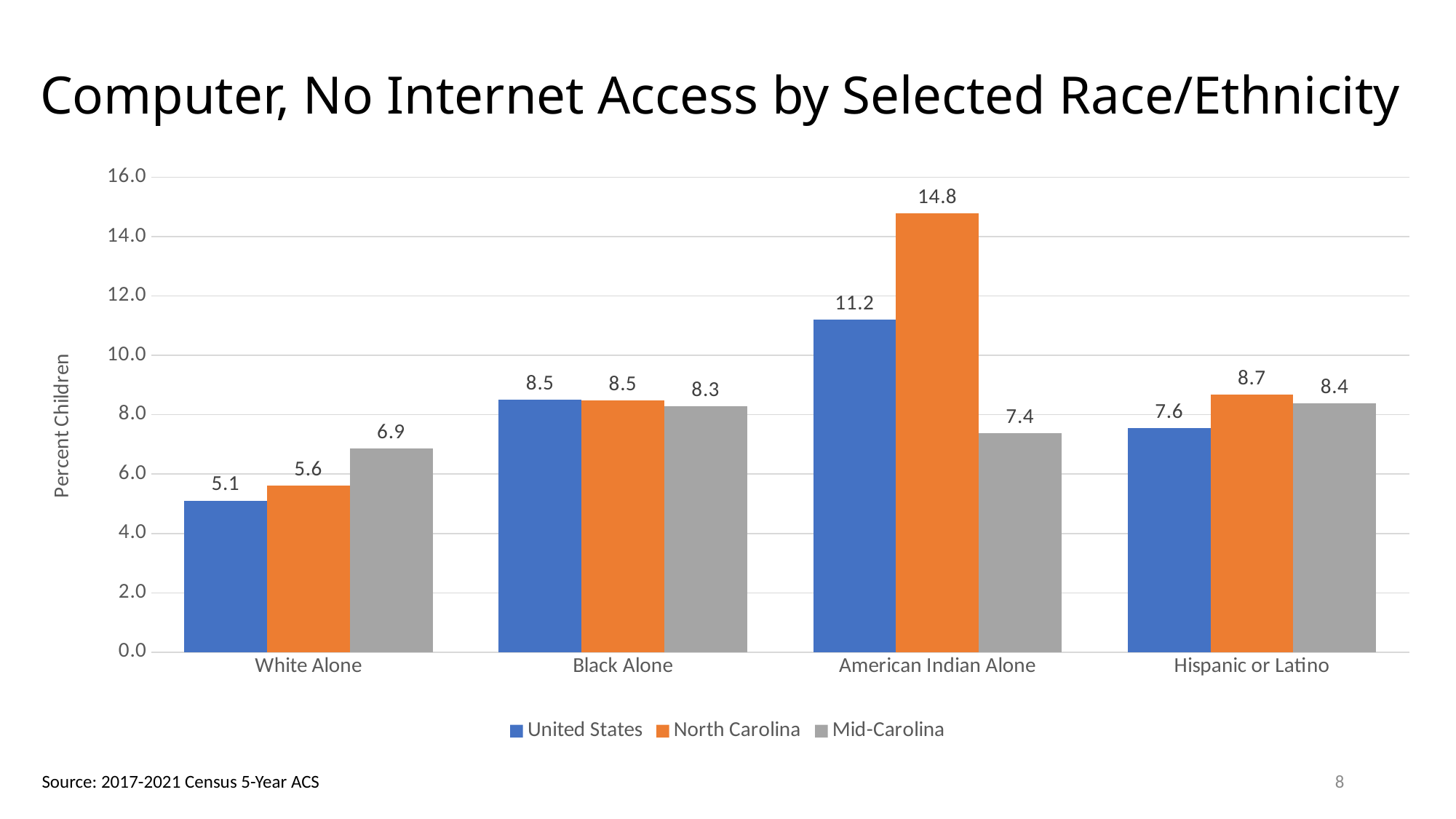
Which category has the highest North Carolina value? American Indian Alone What is the United States value for White Alone? 5.1 How many race/ethnicity categories are shown on the x axis? 4 How many series does the legend list? 3 What is the difference between the North Carolina and Mid-Carolina values for American Indian Alone? 7.4 Is the United States value for American Indian Alone greater or less than 10.0? greater What is the North Carolina value for American Indian Alone? 14.8 What is the label of the vertical axis? Percent Children Which category has the lowest Mid-Carolina value? White Alone What is the Mid-Carolina value for Hispanic or Latino? 8.4 Which is larger for White Alone: the North Carolina value or the Mid-Carolina value? Mid-Carolina What kind of chart is shown on the slide? bar chart